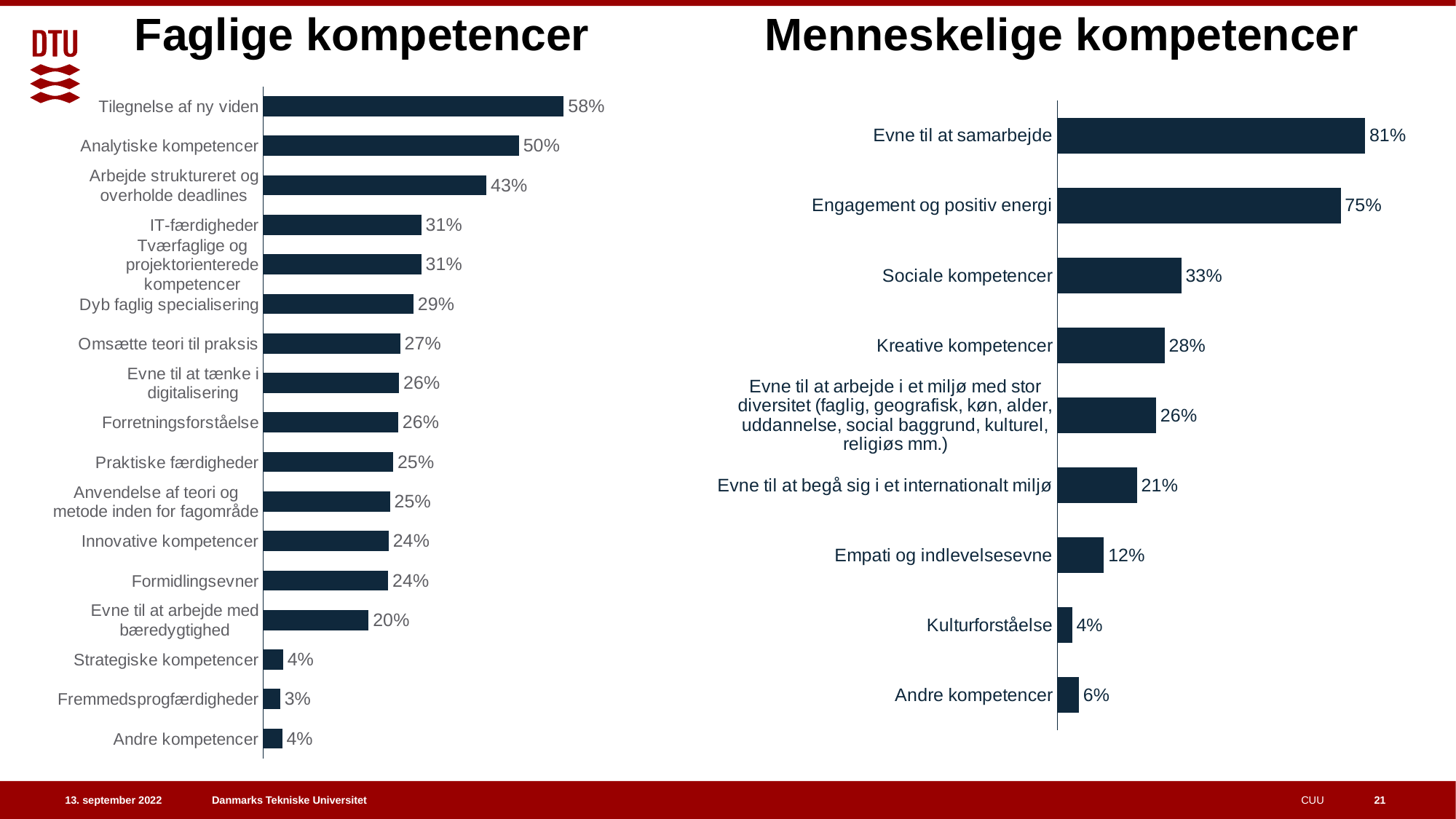
In the 'Menneskelige kompetencer' chart, which category has the lowest value? Kulturforståelse In the 'Menneskelige kompetencer' chart, how many categories are shown? 9 In the 'Faglige kompetencer' chart, what is the value for Evne til at arbejde med bæredygtighed? 20% What type of chart is the 'Menneskelige kompetencer' chart? Bar chart In the 'Menneskelige kompetencer' chart, what is the value for Engagement og positiv energi? 75% In the 'Menneskelige kompetencer' chart, which category has the highest value? Evne til at samarbejde In the 'Faglige kompetencer' chart, which category has the lowest value? Fremmedsprogfærdigheder In the 'Menneskelige kompetencer' chart, what is the difference between Evne til at samarbejde and Sociale kompetencer? 48% In the 'Faglige kompetencer' chart, how many categories are shown? 17 In the 'Menneskelige kompetencer' chart, which is larger: Empati og indlevelsesevne or Andre kompetencer? Empati og indlevelsesevne In the 'Faglige kompetencer' chart, what is the value for Tilegnelse af ny viden? 58% In the 'Faglige kompetencer' chart, what is the difference between Analytiske kompetencer and Arbejde struktureret og overholde deadlines? 7%